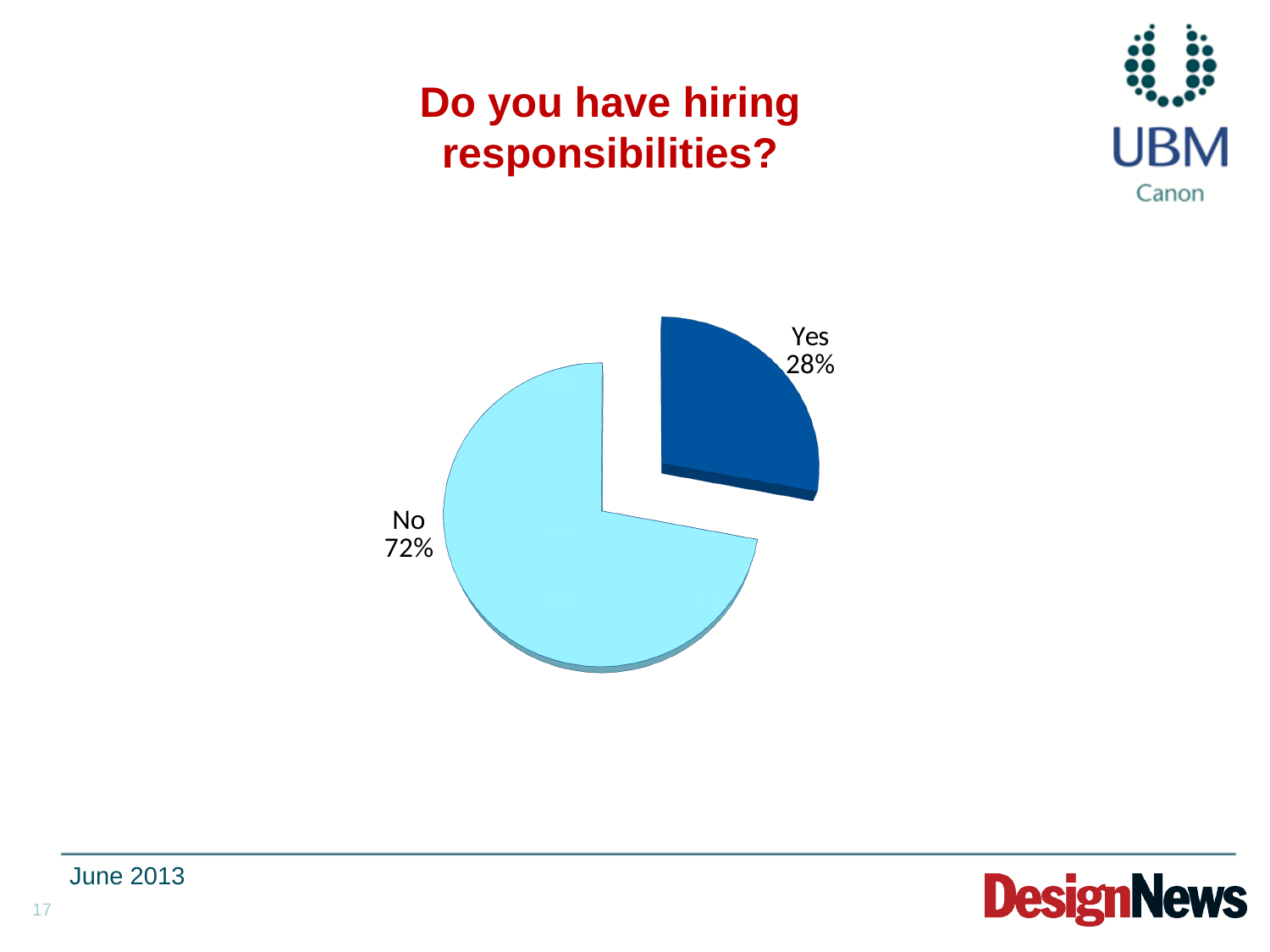
What is the difference in percentage points between the No and Yes slices? 44 What question does the chart title ask? Do you have hiring responsibilities? Which response has the smallest share of the pie? Yes What kind of chart is shown on the slide? Pie chart Which slice is shown in dark blue? Yes What share of the pie does the Yes slice represent? 28% Which slice is larger, Yes or No? No How many slices does the pie chart have? 2 What percentage of respondents answered Yes to having hiring responsibilities? 28% What percentage of respondents answered No to having hiring responsibilities? 72% Which response has the largest share of the pie? No